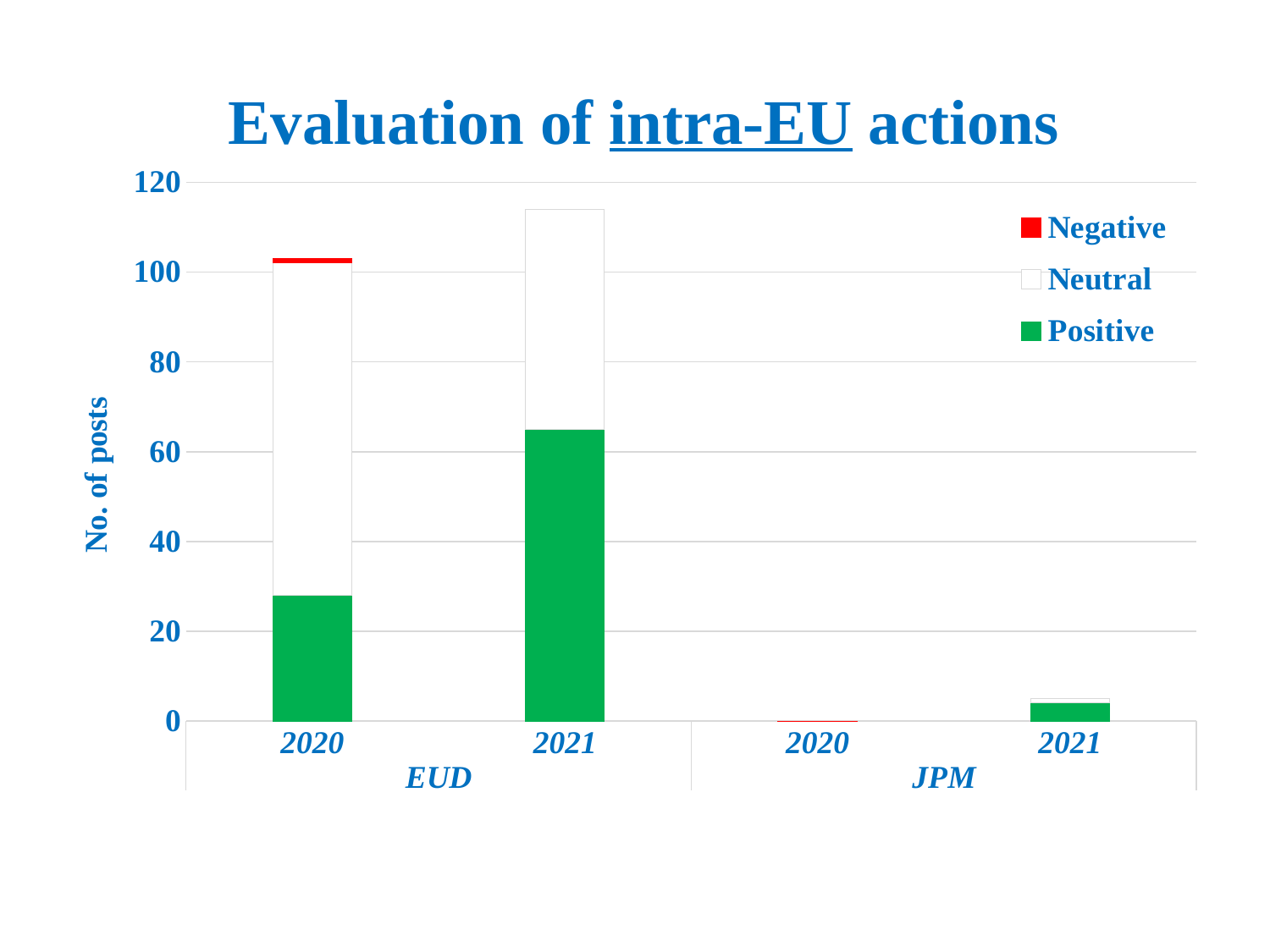
Which bar is the shortest overall? JPM 2020 Is the total height of the EUD 2021 bar greater or less than 100? greater Is the total height of the JPM 2021 bar greater or less than 20? less Is the Positive value for EUD 2020 greater or less than 40? less Which bar is the tallest overall? EUD 2021 What is the label on the vertical axis? No. of posts Which has the larger Positive value, EUD 2020 or EUD 2021? EUD 2021 For EUD, does the total number of posts rise or fall from 2020 to 2021? rise How many series does the legend list? 3 How many bars are plotted in the chart? 4 What kind of chart is shown on the slide? Stacked bar chart